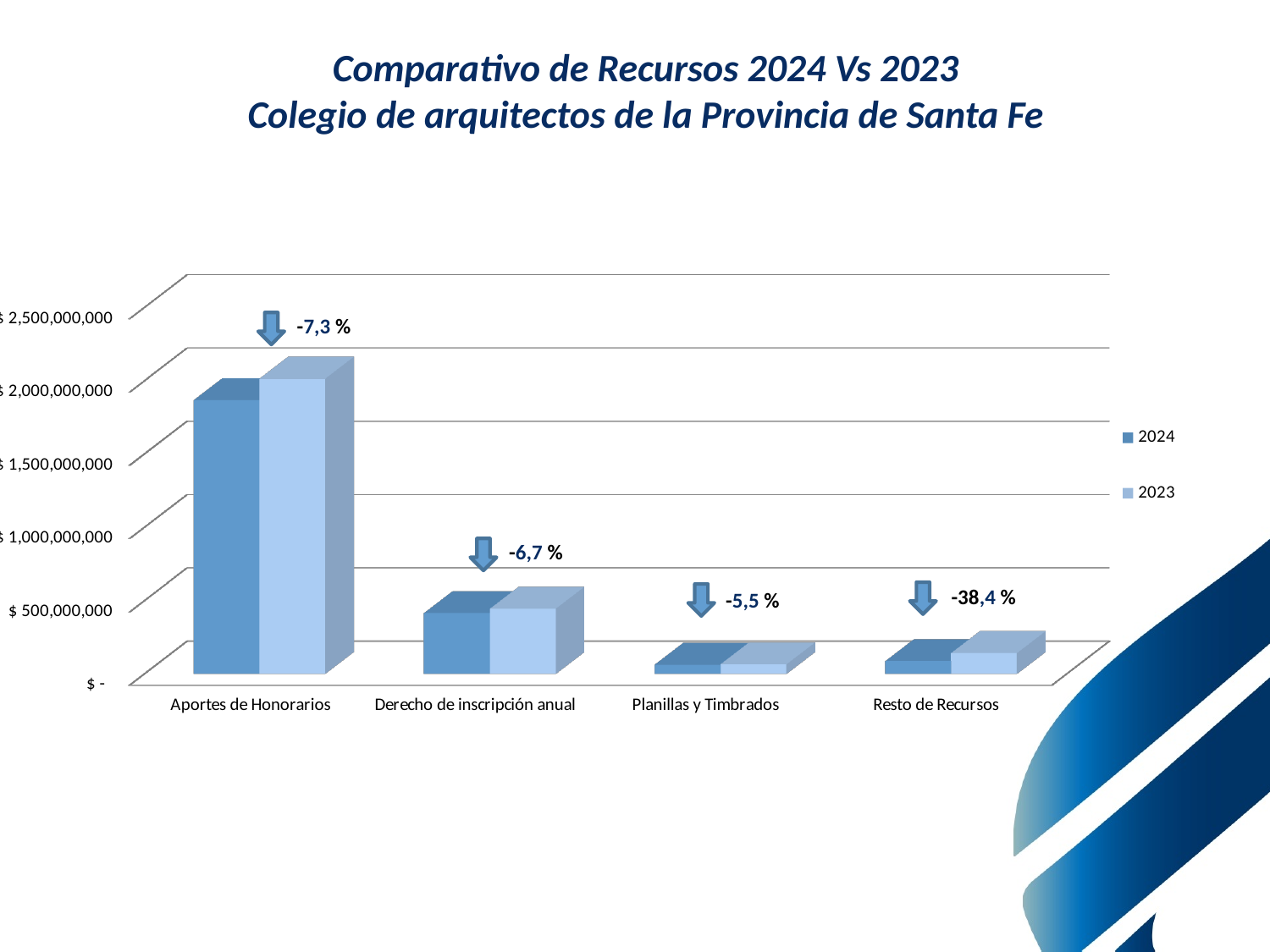
Is the 2024 value for Derecho de inscripción anual greater or less than $ 500,000,000? less Which category has the lowest values in the chart? Planillas y Timbrados For Aportes de Honorarios, which is larger: the 2024 value or the 2023 value? 2023 What percentage change is annotated above the Planillas y Timbrados bars? -5,5 % What kind of chart is shown on the slide? Bar chart What percentage change is annotated above the Aportes de Honorarios bars? -7,3 % Is the 2024 value for Aportes de Honorarios greater or less than $ 1,500,000,000? greater Which category has the highest values in the chart? Aportes de Honorarios What percentage change is annotated above the Resto de Recursos bars? -38,4 % How many categories are shown on the x axis of the chart? 4 How many series does the chart legend list? 2 What are the two series listed in the chart legend? 2024 and 2023